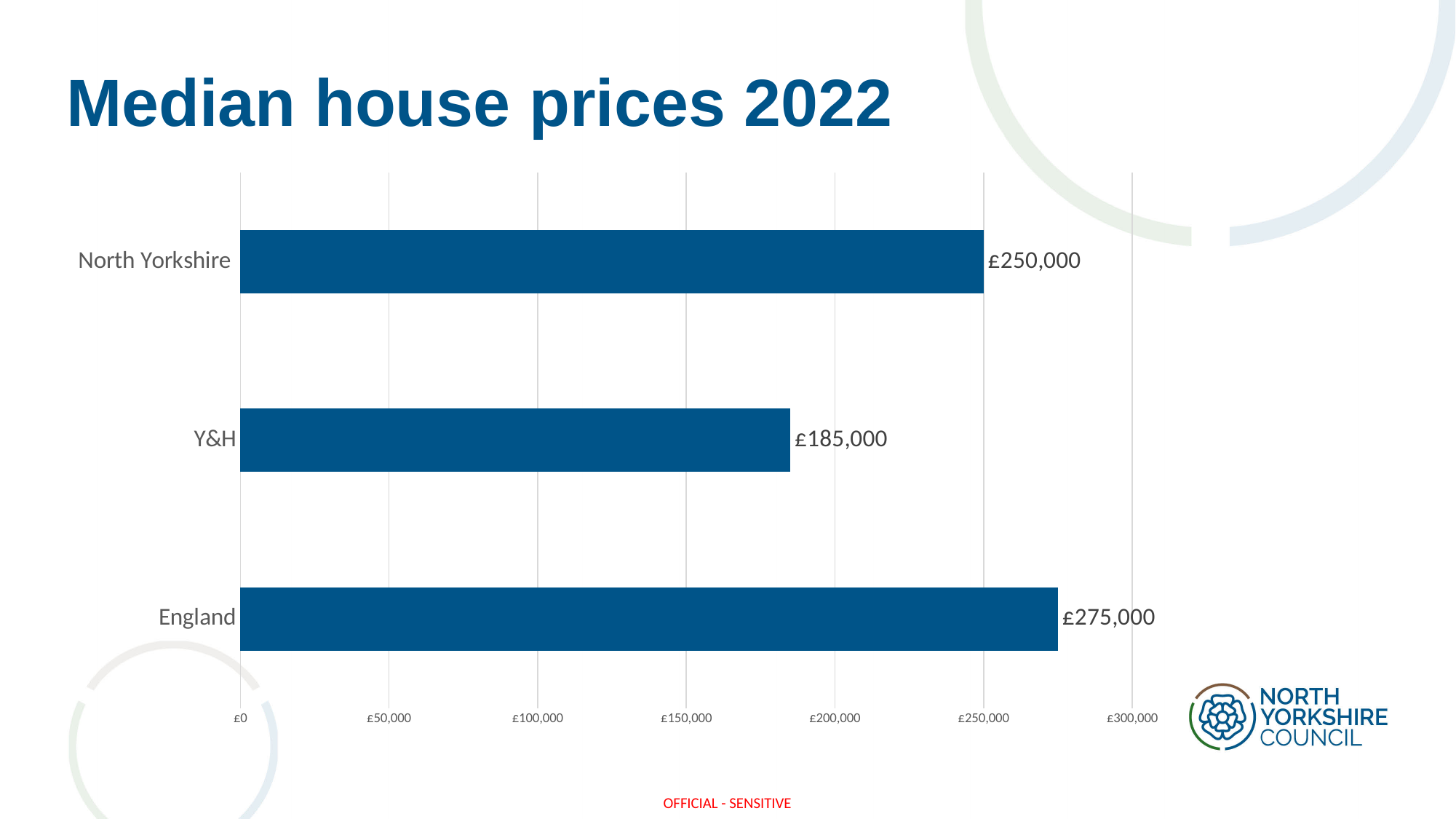
Is the median house price for Y&H greater or less than £200,000? less What is the median house price for North Yorkshire? £250,000 What kind of chart is shown on the slide? bar chart What is the median house price for Y&H? £185,000 Which area has the highest median house price? England How many areas are shown in the chart? 3 What is the difference between the median house price in North Yorkshire and in Y&H? £65,000 What is the median house price for England? £275,000 What is the difference between the median house price in England and in North Yorkshire? £25,000 Which area has the lowest median house price? Y&H What is the title of the slide? Median house prices 2022 Which has a higher median house price, North Yorkshire or Y&H? North Yorkshire